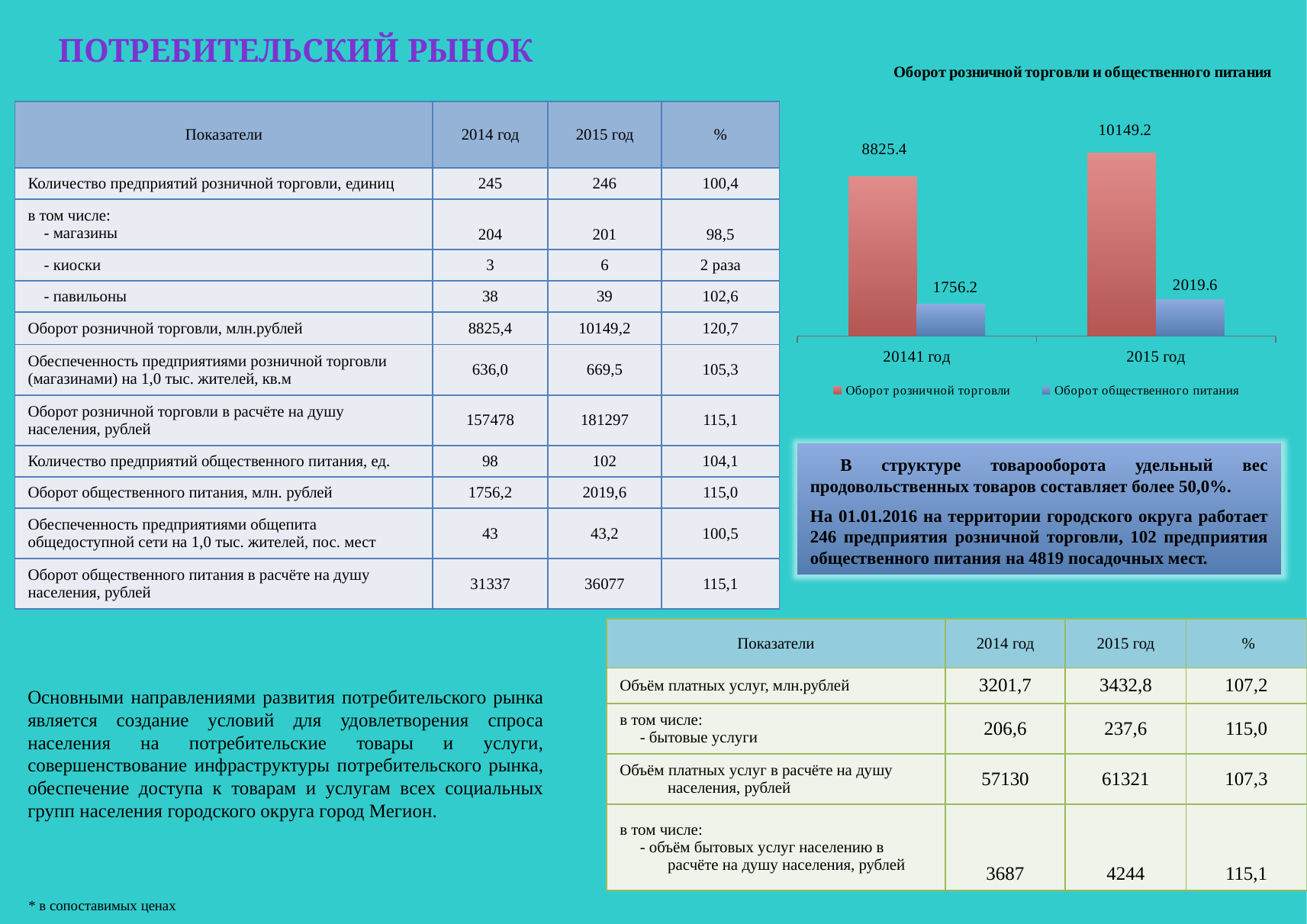
What is the difference between Оборот розничной торговли in 2015 год and in the first category group? 1323.8 What is the value of Оборот общественного питания for 2015 год in the chart? 2019.6 What is the title of the chart on the slide? Оборот розничной торговли и общественного питания What type of chart is shown on the slide? bar chart Which bar in the chart has the lowest value? Оборот общественного питания, first (left) category group What is the value of Оборот розничной торговли for 2015 год in the chart? 10149.2 What is the value of Оборот розничной торговли in the first (left) category group of the chart? 8825.4 How many series does the chart legend list? 2 Does Оборот общественного питания rise or fall from the first category group to 2015 год? rise How many category groups are shown on the x axis of the chart? 2 What is the value of Оборот общественного питания in the first (left) category group of the chart? 1756.2 Which bar in the chart has the highest value? Оборот розничной торговли, 2015 год